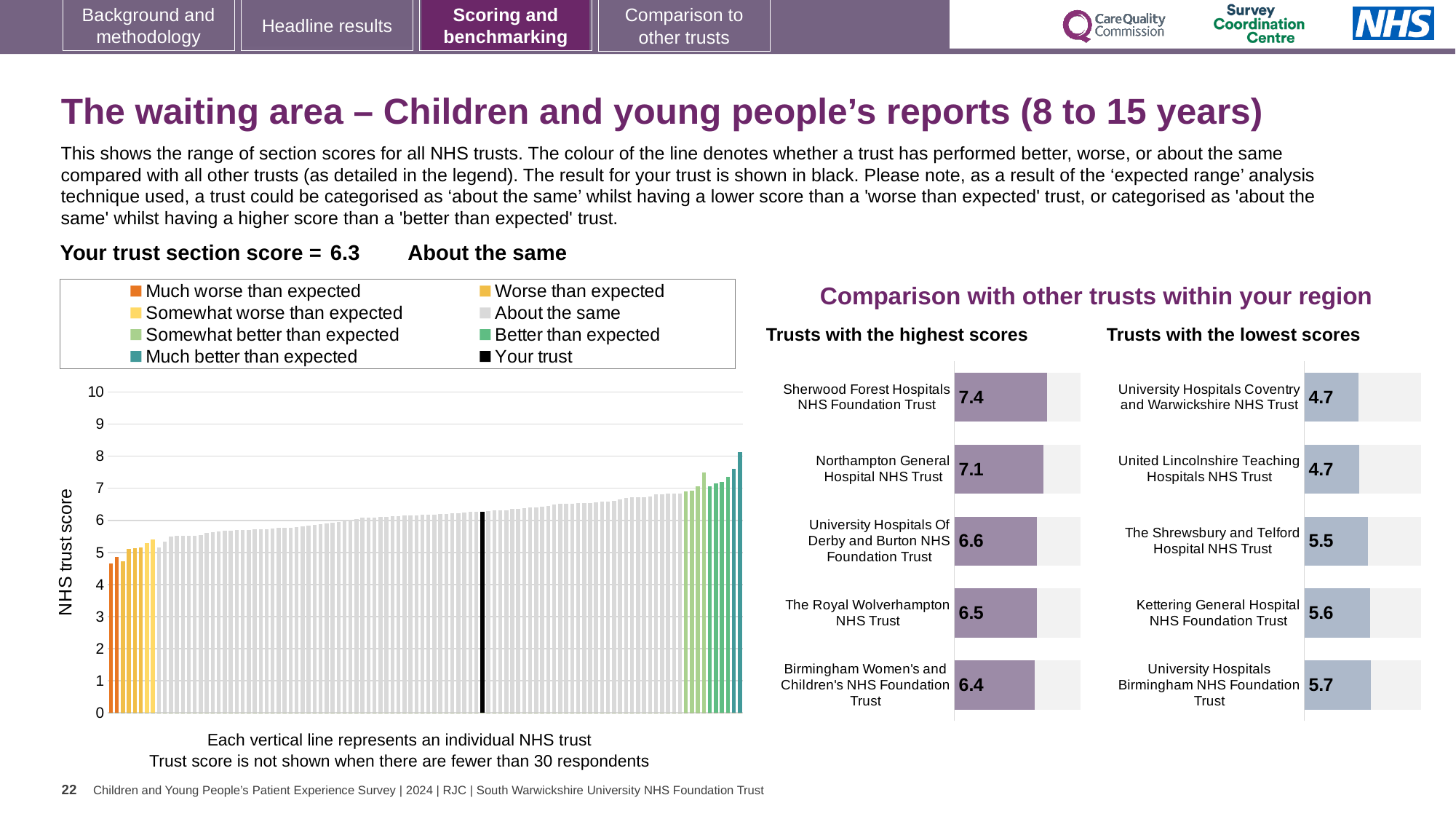
In the 'Trusts with the highest scores' chart, which trust has the highest score? Sherwood Forest Hospitals NHS Foundation Trust How many trusts are shown in the 'Trusts with the highest scores' chart? 5 How many entries does the legend of the main 'NHS trust score' chart list? 8 What kind of chart is the main 'NHS trust score' chart on the left of the slide? Bar chart In the 'Trusts with the highest scores' chart, what is the difference between the scores of Sherwood Forest Hospitals NHS Foundation Trust and Northampton General Hospital NHS Trust? 0.3 In the 'Trusts with the lowest scores' chart, what is the difference between the scores of University Hospitals Birmingham NHS Foundation Trust and The Shrewsbury and Telford Hospital NHS Trust? 0.2 In the main 'NHS trust score' chart, is the value of the lowest (leftmost) bar greater or less than 5? less In the 'Trusts with the highest scores' chart, what is the score for Sherwood Forest Hospitals NHS Foundation Trust? 7.4 In the 'Trusts with the highest scores' chart, which has the higher score: The Royal Wolverhampton NHS Trust or Birmingham Women's and Children's NHS Foundation Trust? The Royal Wolverhampton NHS Trust In the 'Trusts with the lowest scores' chart, what is the score for Kettering General Hospital NHS Foundation Trust? 5.6 In the main 'NHS trust score' chart, do the bar values rise or fall from left to right? Rise In the 'Trusts with the lowest scores' chart, which trust has the highest score? University Hospitals Birmingham NHS Foundation Trust